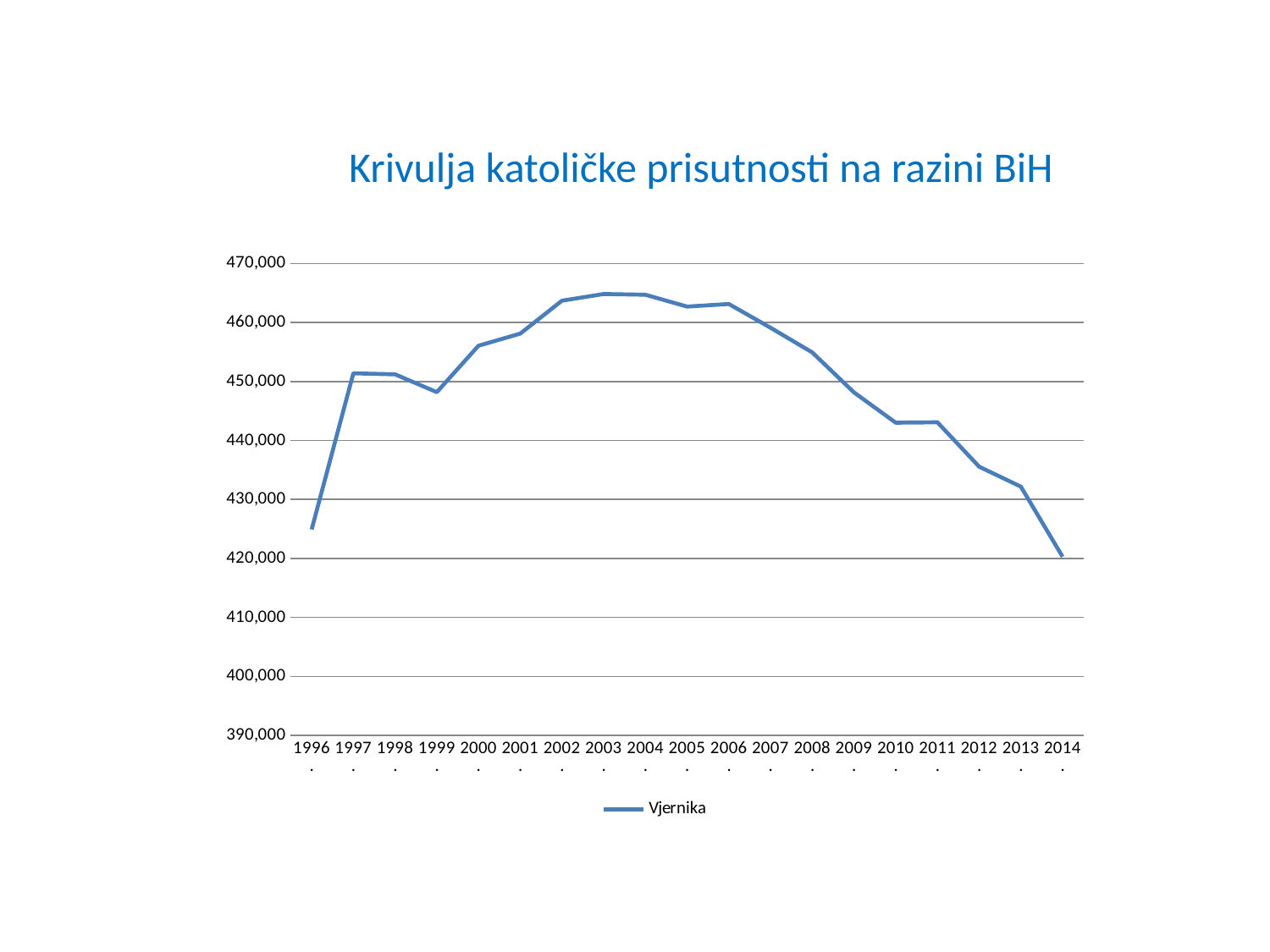
Do the values rise or fall from 2006 to 2014? fall What is the name of the series shown in the legend? Vjernika How many years are plotted along the x axis? 19 Is the value for 1996 greater or less than 430,000? less Is the value for 2012 greater or less than 440,000? less Is the value for 2003 greater or less than 460,000? greater Which year has the lowest value? 2014 How many series does the legend list? 1 What is the title of the chart? Krivulja katoličke prisutnosti na razini BiH Which is larger, the value for 2002 or the value for 2009? 2002 What kind of chart is shown on the slide? line chart